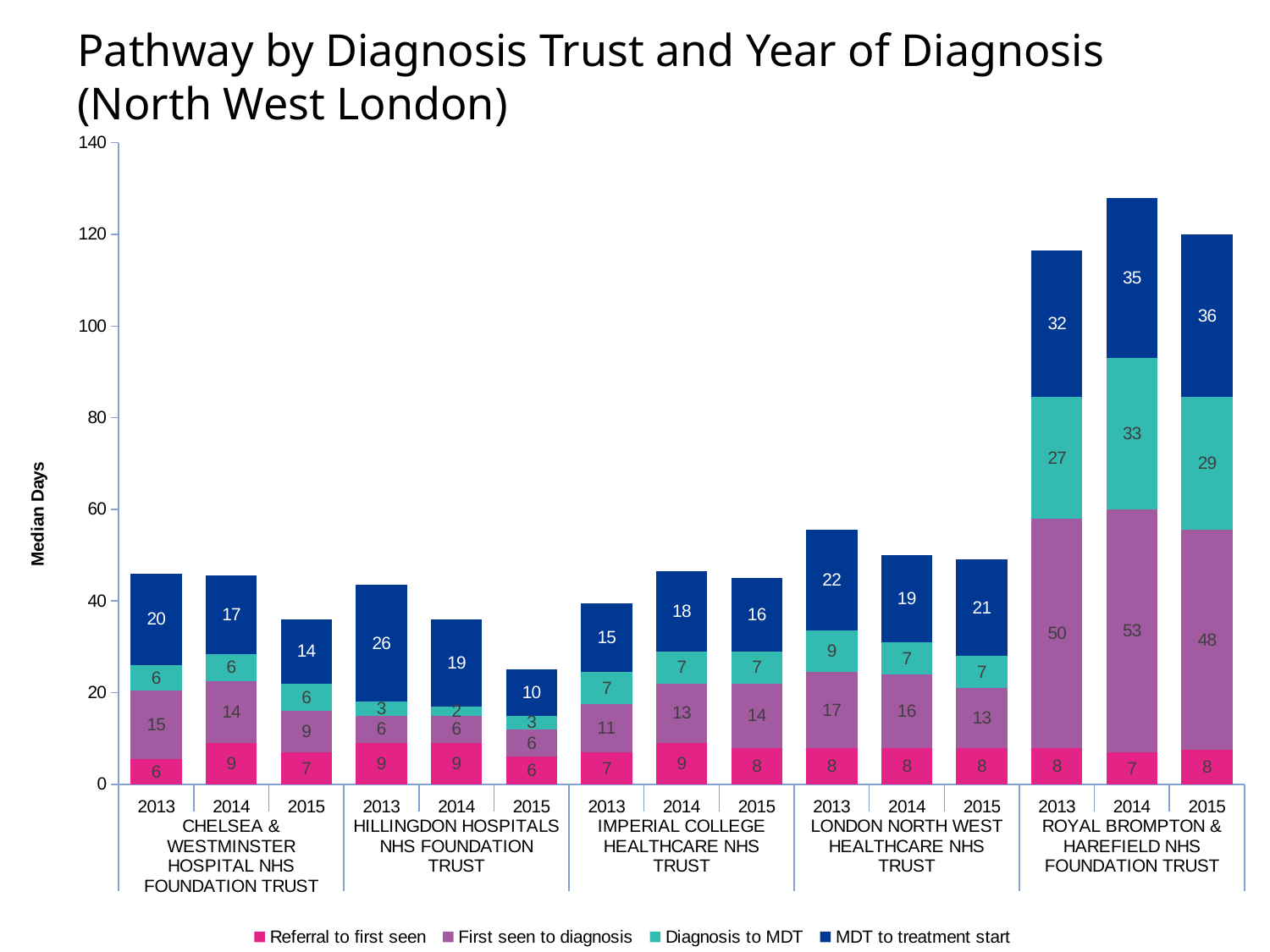
How many series does the legend list? 4 How many bars are plotted in the chart? 15 What is the median days for MDT to treatment start at Hillingdon Hospitals NHS Foundation Trust in 2013? 26 What is the total median days for the 2015 bar at Hillingdon Hospitals NHS Foundation Trust? 25 Which is larger: MDT to treatment start in 2013 at Hillingdon Hospitals NHS Foundation Trust or at Chelsea & Westminster Hospital NHS Foundation Trust? Hillingdon Hospitals NHS Foundation Trust Which trust and year has the shortest stacked bar? Hillingdon Hospitals NHS Foundation Trust, 2015 What is the difference in MDT to treatment start median days between 2015 and 2013 at Royal Brompton & Harefield NHS Foundation Trust? 4 What is the median days for First seen to diagnosis at Royal Brompton & Harefield NHS Foundation Trust in 2014? 53 Is the total height of the 2013 bar for Royal Brompton & Harefield NHS Foundation Trust greater or less than 100? greater What kind of chart is shown on the slide? Stacked bar chart Which trust and year has the tallest stacked bar? Royal Brompton & Harefield NHS Foundation Trust, 2014 What is the median days for Diagnosis to MDT at London North West Healthcare NHS Trust in 2013? 9